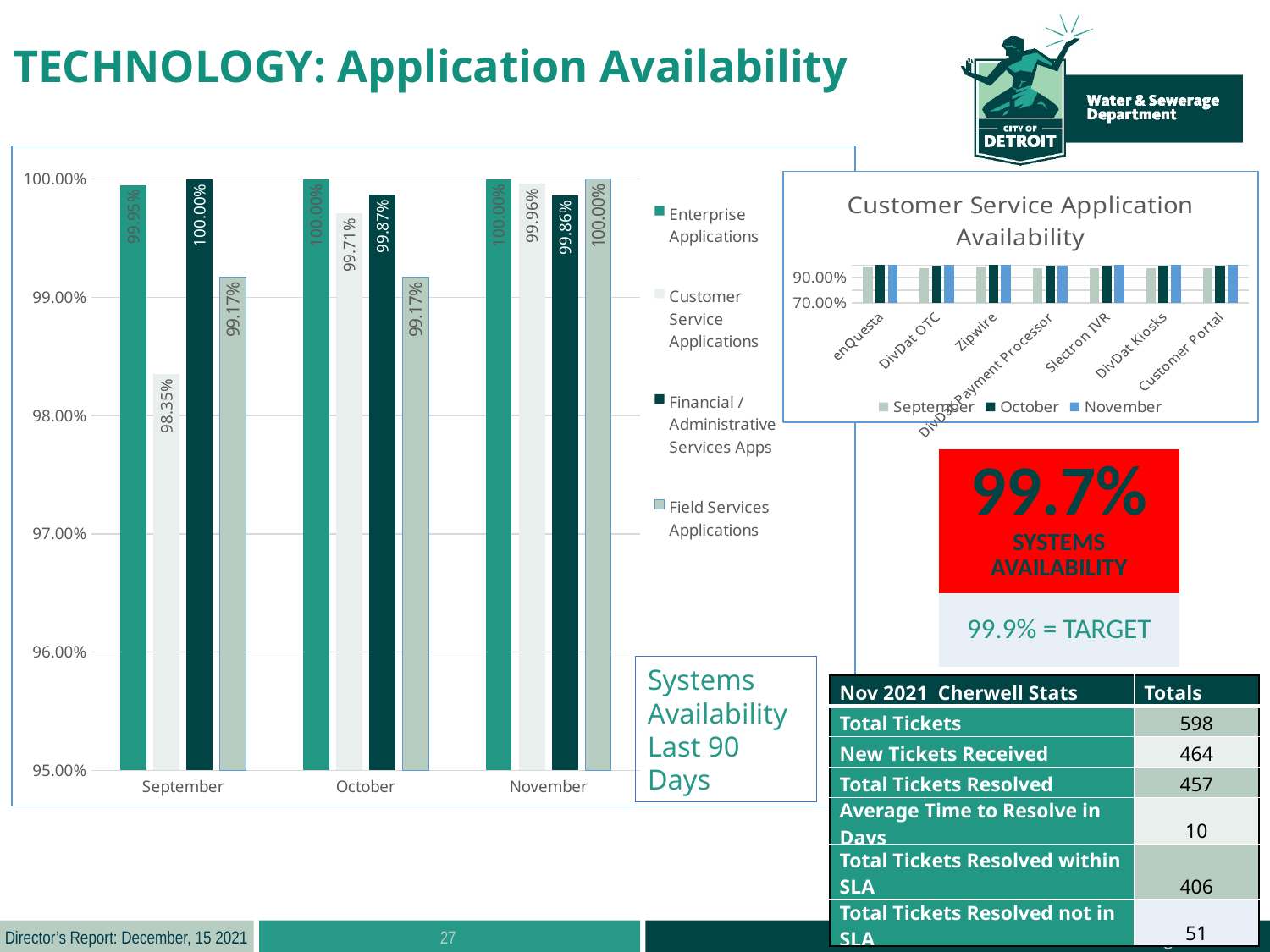
In the Systems Availability Last 90 Days chart, what is the difference between the Customer Service Applications values for November and September? 1.61% What kind of chart is the Customer Service Application Availability chart? bar chart In the Systems Availability Last 90 Days chart, what is the value for Customer Service Applications in September? 98.35% How many series does the legend of the Customer Service Application Availability chart list? 3 In the Systems Availability Last 90 Days chart, what is the value for Financial / Administrative Services Apps in October? 99.87% In the Systems Availability Last 90 Days chart, which series has the lowest value in September? Customer Service Applications In the Systems Availability Last 90 Days chart, what is the value for Field Services Applications in November? 100.00% In the Systems Availability Last 90 Days chart, what is the value for Enterprise Applications in September? 99.95% In the Systems Availability Last 90 Days chart, does the value for Customer Service Applications rise or fall from September to November? rise In the Systems Availability Last 90 Days chart, which is larger in October: Customer Service Applications or Field Services Applications? Customer Service Applications How many series does the legend of the Systems Availability Last 90 Days chart list? 4 How many months are shown on the x axis of the Systems Availability Last 90 Days chart? 3